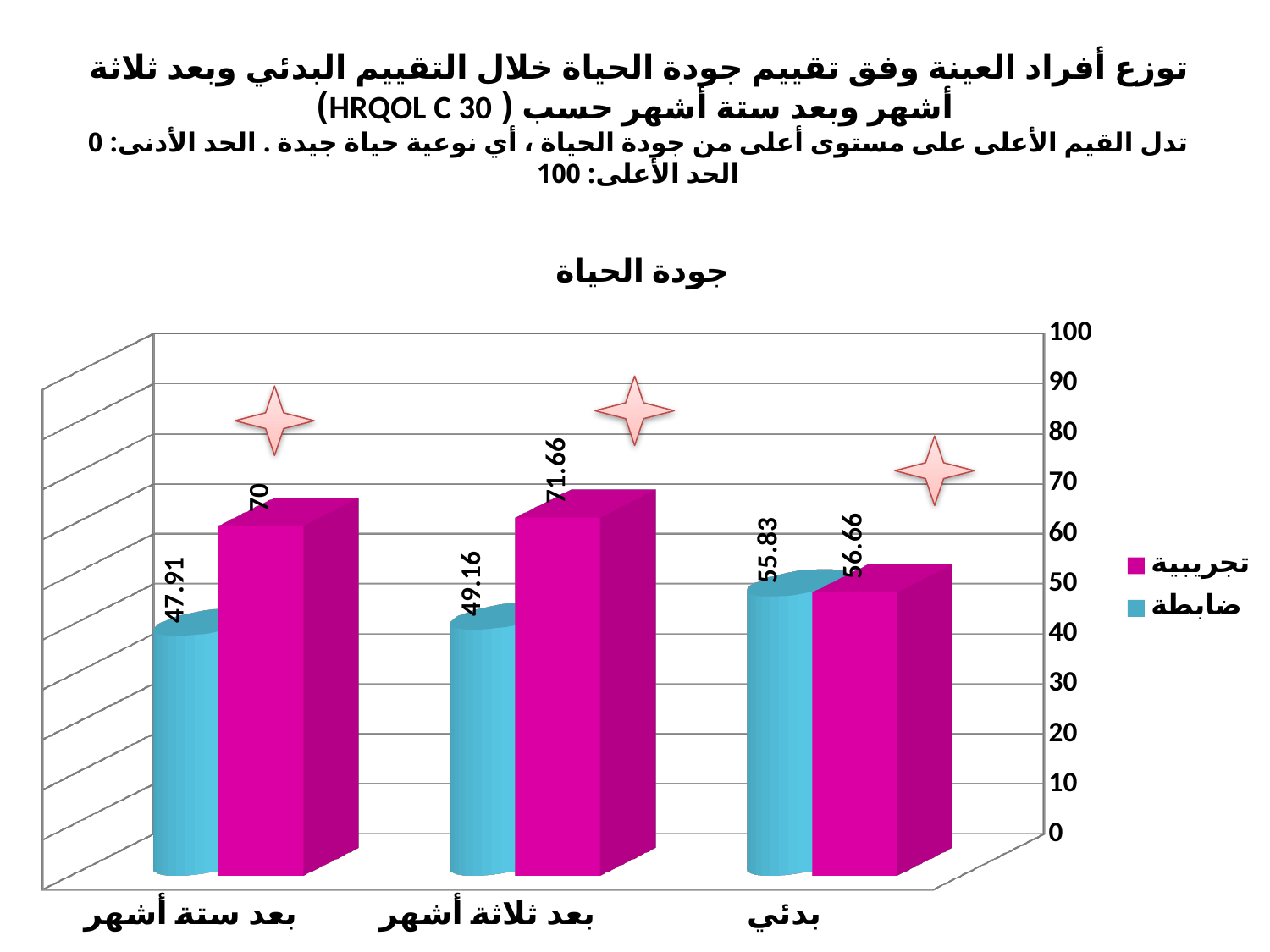
What is the difference between the تجريبية and ضابطة values at بعد ثلاثة أشهر? 22.5 What is the value for the تجريبية series at بعد ثلاثة أشهر? 71.66 Which category has the lowest value for the ضابطة series? بعد ستة أشهر How many categories are shown on the x axis? 3 At بعد ستة أشهر, which series has the larger value, تجريبية or ضابطة? تجريبية What is the value for the ضابطة series at بعد ستة أشهر? 47.91 What is the value for the ضابطة series at بدئي? 55.83 What is the title of the chart? جودة الحياة How many series does the legend list? 2 Which category has the highest value for the تجريبية series? بعد ثلاثة أشهر What is the value for the تجريبية series at بعد ستة أشهر? 70 What kind of chart is shown? bar chart